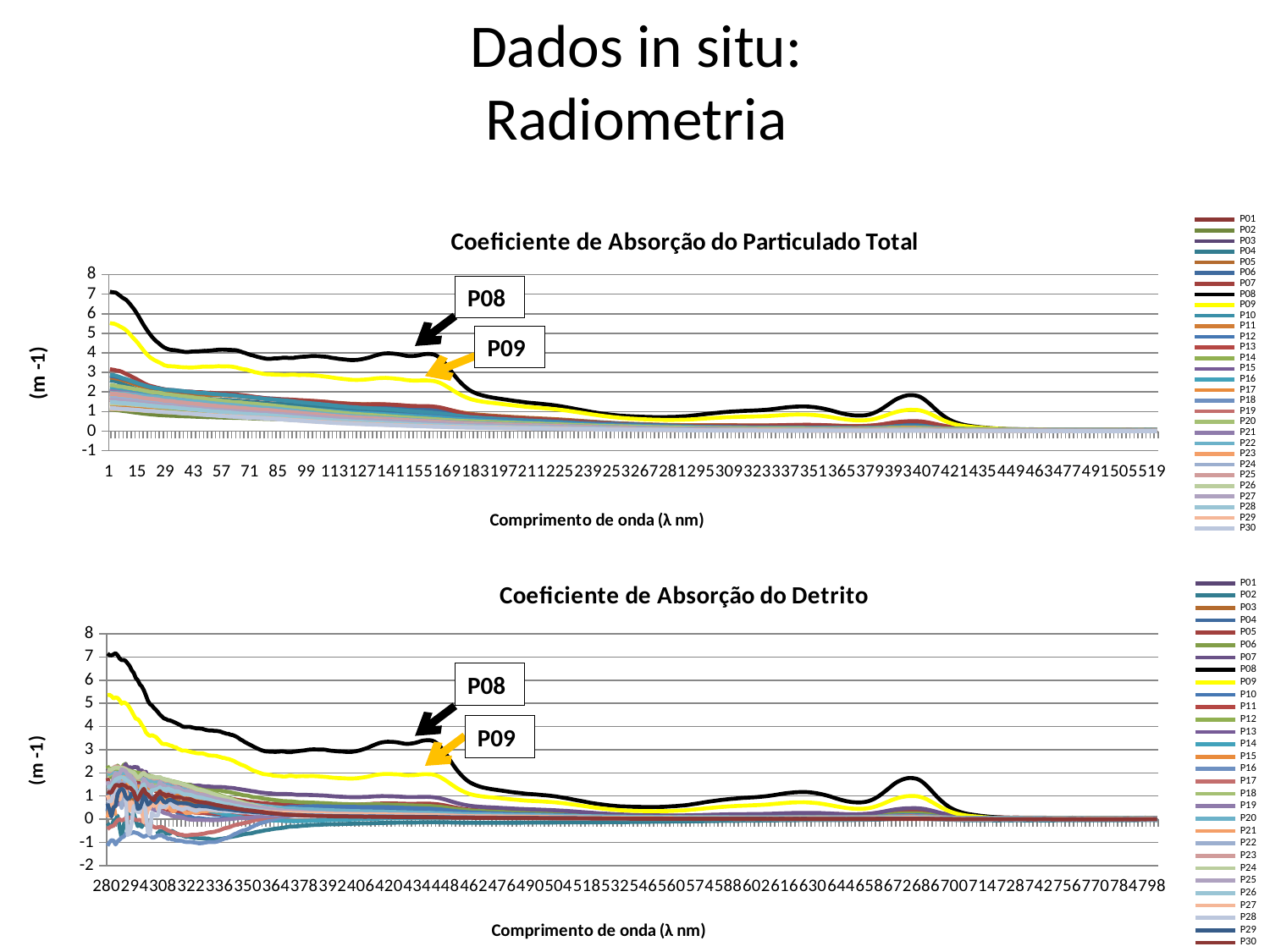
In the 'Coeficiente de Absorção do Detrito' chart, which series has higher values, P08 or P09? P08 How many series does the legend of the 'Coeficiente de Absorção do Detrito' chart list? 30 What is the title of the top chart on the slide? Coeficiente de Absorção do Particulado Total In the 'Coeficiente de Absorção do Detrito' chart, is the value of P09 at the right end of the x axis greater or less than 1? less What type of chart is the 'Coeficiente de Absorção do Particulado Total' chart? line chart In the 'Coeficiente de Absorção do Particulado Total' chart, which series reaches the highest value? P08 In the 'Coeficiente de Absorção do Particulado Total' chart, do the values of P08 generally rise or fall as wavelength increases? fall In the 'Coeficiente de Absorção do Particulado Total' chart, is the highest value of P09 greater or less than 4? greater What is the x-axis label of the 'Coeficiente de Absorção do Detrito' chart? Comprimento de onda (λ nm) In the 'Coeficiente de Absorção do Particulado Total' chart, is the highest value of P08 greater or less than 6? greater